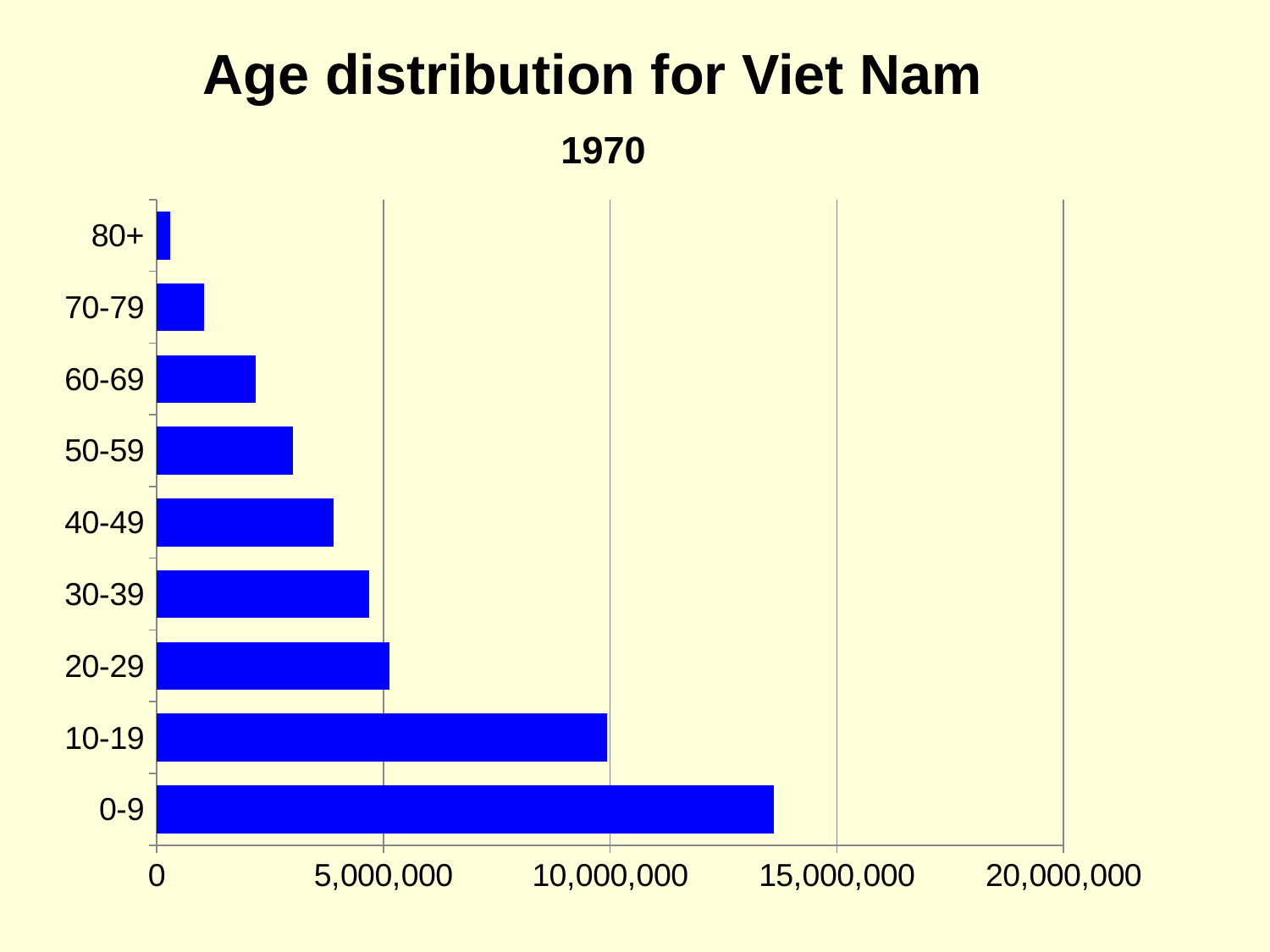
Is the value for the 30-39 age group greater or less than 5,000,000? less Is the value for the 50-59 age group greater or less than 5,000,000? less Which is larger, the value for 0-9 or the value for 10-19? 0-9 Which age group has the lowest value? 80+ Which is larger, the value for 60-69 or the value for 70-79? 60-69 Is the value for the 0-9 age group greater or less than 10,000,000? greater What year does the chart subtitle give? 1970 What kind of chart is shown on the slide? bar chart Do the values rise or fall as the age groups get older? fall Which age group has the highest value? 0-9 How many age groups are plotted in the chart? 9